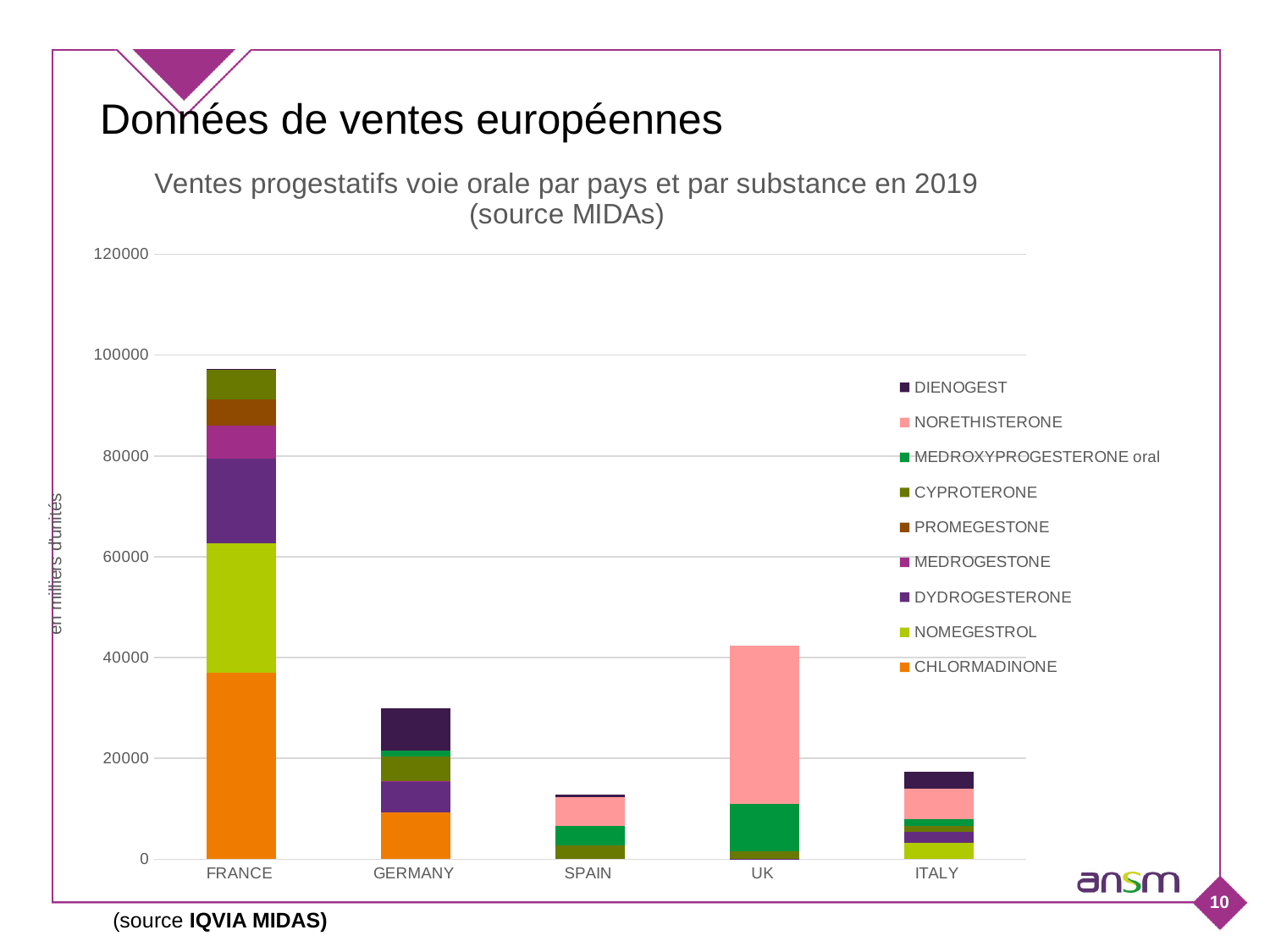
How many countries are shown on the x axis of the chart? 5 Which country has the lowest total sales in the chart? SPAIN What kind of chart is shown on the slide? Stacked bar chart What is the title of the chart? Ventes progestatifs voie orale par pays et par substance en 2019 (source MIDAs) Is the total value for UK greater or less than 40000? greater Is the total value for FRANCE greater or less than 80000? greater Which country has the highest total sales in the chart? FRANCE Which substance makes up the largest part of the UK bar? NORETHISTERONE Which country has a larger total, UK or GERMANY? UK Is the total value for ITALY greater or less than 20000? less How many substances does the legend list? 9